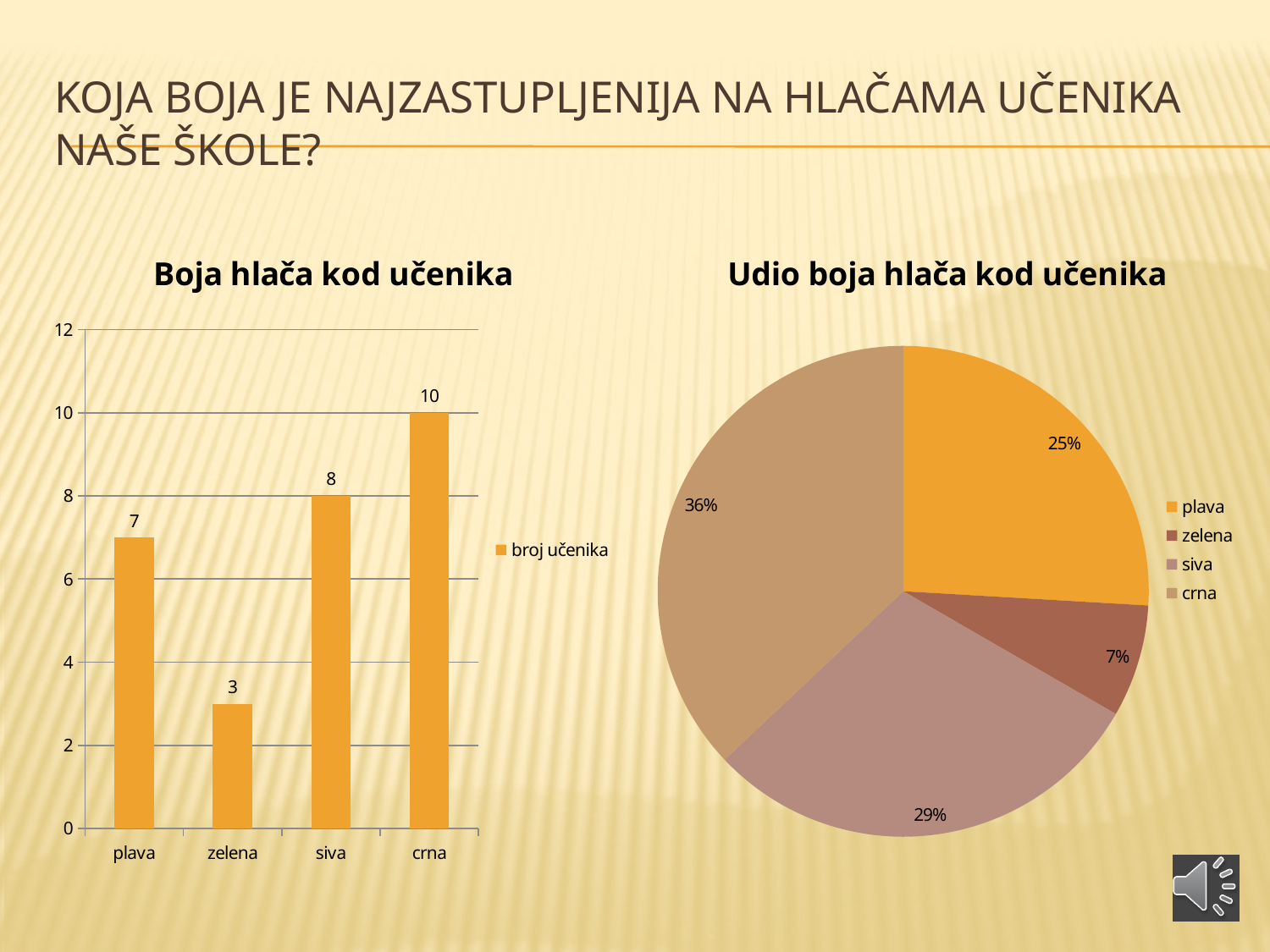
What kind of chart is the chart titled "Boja hlača kod učenika"? bar chart In the chart titled "Boja hlača kod učenika", what series name does the legend show? broj učenika In the chart titled "Boja hlača kod učenika", what is the difference between the values for crna and plava? 3 In the chart titled "Boja hlača kod učenika", how many categories are shown on the x axis? 4 In the chart titled "Boja hlača kod učenika", which category has the lowest value? zelena In the chart titled "Boja hlača kod učenika", what is the value for zelena? 3 In the chart titled "Boja hlača kod učenika", which category has the highest value? crna What kind of chart is the chart titled "Udio boja hlača kod učenika"? pie chart In the chart titled "Boja hlača kod učenika", what is the value for crna? 10 In the chart titled "Udio boja hlača kod učenika", which slice is the smallest? zelena In the chart titled "Udio boja hlača kod učenika", what share of the pie does siva have? 29% In the chart titled "Boja hlača kod učenika", which is larger, the value for siva or the value for plava? siva